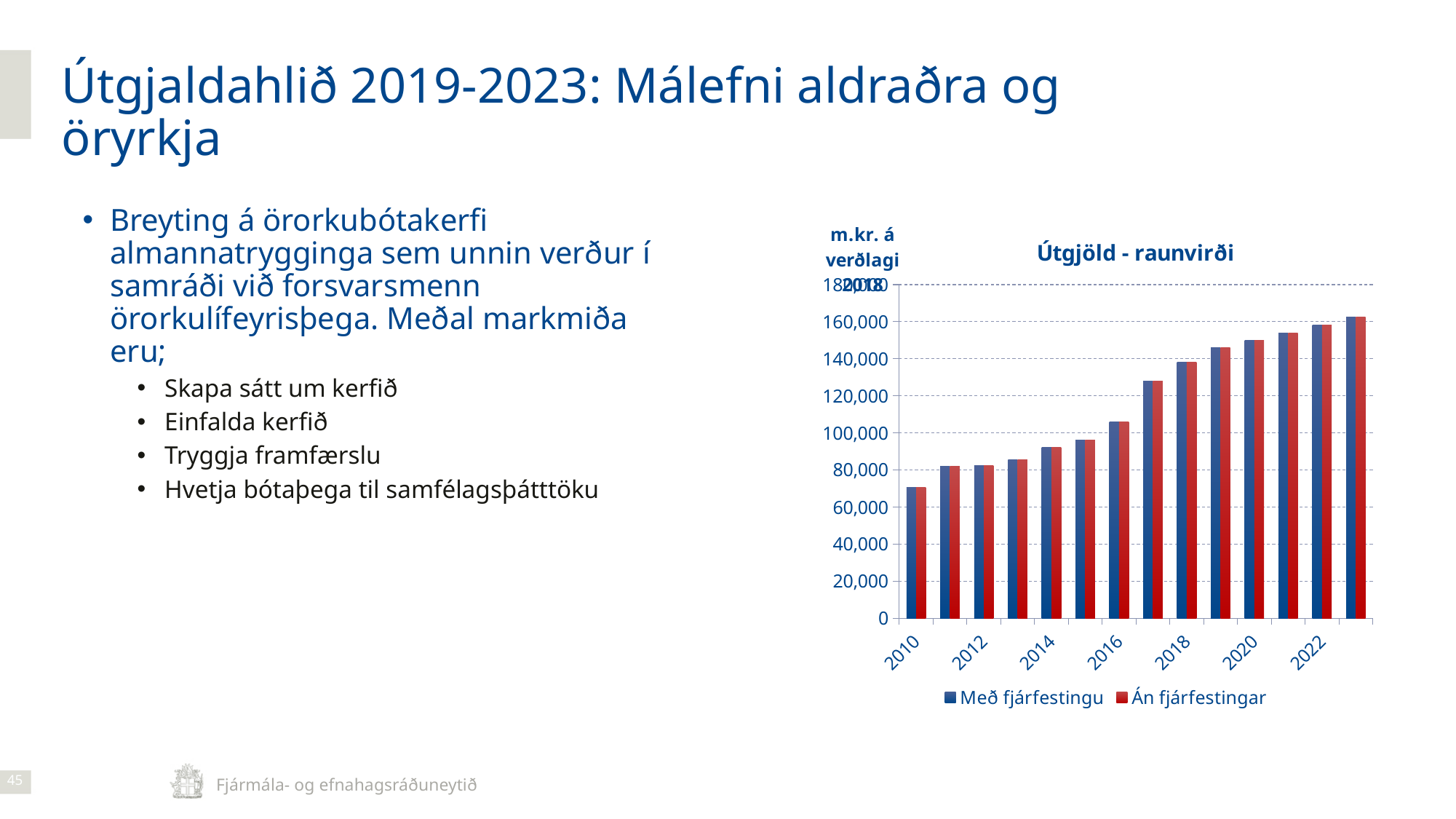
Is the value for Með fjárfestingu in 2020 greater or less than 140,000? greater Is the value for Án fjárfestingar in 2016 greater or less than 100,000? greater Which year has the lowest value for Með fjárfestingu? 2010 How many years are plotted in the chart? 14 Is the value for Með fjárfestingu in 2010 greater or less than 80,000? less Which year has the highest value for Með fjárfestingu? 2023 Do the values in the chart rise or fall from 2010 to 2023? rise What kind of chart is shown on the slide? bar chart What is the title of the chart? Útgjöld - raunvirði How many series does the chart legend list? 2 Which is larger for Með fjárfestingu: the value in 2014 or the value in 2016? 2016 Which series is shown in red in the chart? Án fjárfestingar